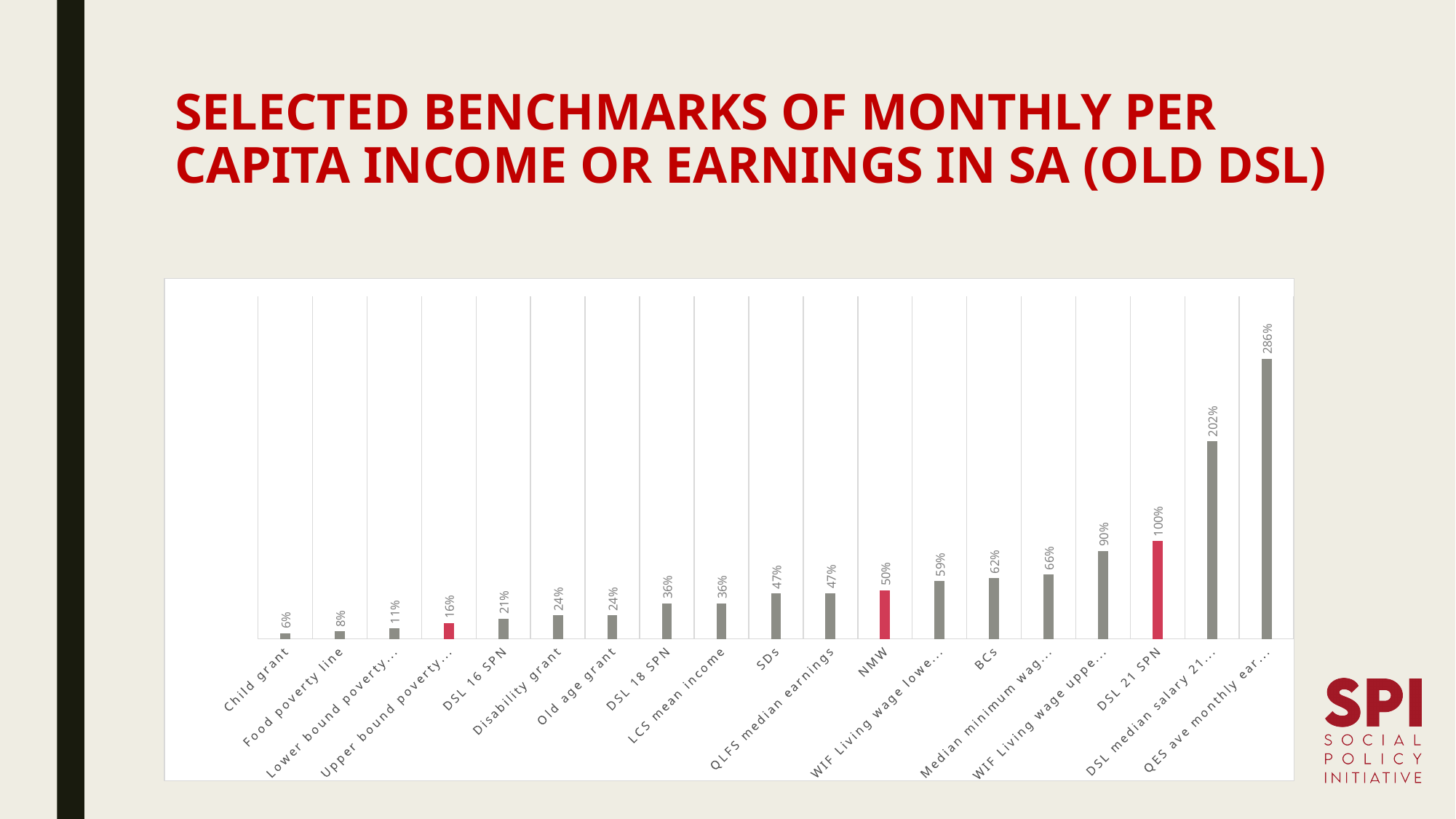
Do the values generally rise or fall from left to right along the x axis? Rise Which is larger, the value for Disability grant or the value for DSL 16 SPN? Disability grant How many categories are plotted in the chart? 19 What is the value for NMW? 50% Which category has the highest value? QES ave monthly ear... How many bars are coloured red rather than grey? 3 What type of chart is shown on the slide? Bar chart What is the value for Child grant? 6% What is the value for DSL 21 SPN? 100% What is the difference between the values for BCs and Food poverty line? 54% What is the value for DSL 18 SPN? 36% Which category has the lowest value? Child grant